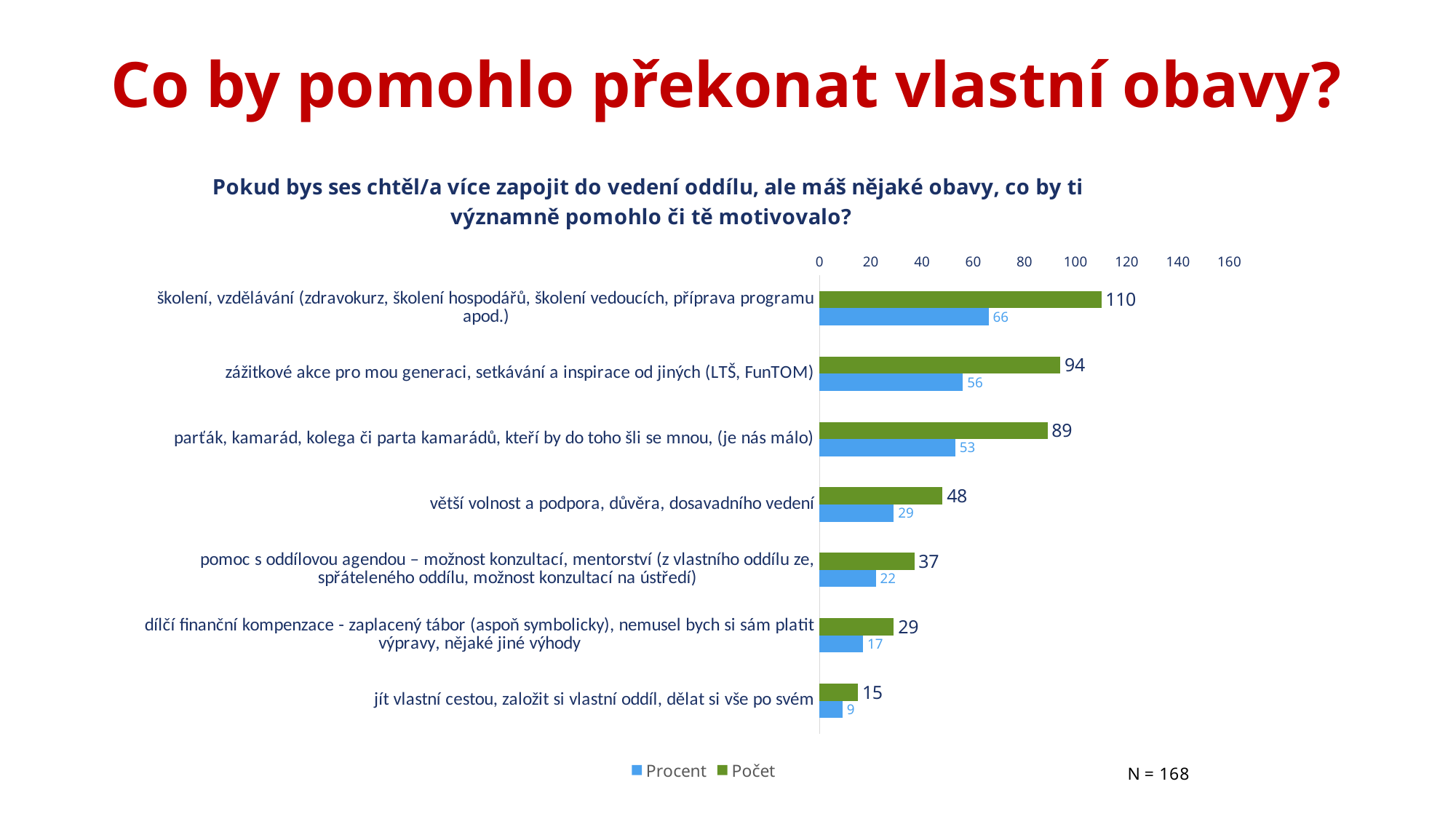
Which has a larger Procent value: "pomoc s oddílovou agendou" or "dílčí finanční kompenzace"? pomoc s oddílovou agendou What is the difference between the Počet values for "zážitkové akce pro mou generaci, setkávání a inspirace od jiných (LTŠ, FunTOM)" and "parťák, kamarád, kolega či parta kamarádů, kteří by do toho šli se mnou, (je nás málo)"? 5 How many categories are shown in the chart? 7 What is the sample size (N) stated on the slide? N = 168 How many series does the legend list? 2 What is the Počet value for "školení, vzdělávání (zdravokurz, školení hospodářů, školení vedoucích, příprava programu apod.)"? 110 What is the Počet value for "větší volnost a podpora, důvěra, dosavadního vedení"? 48 Is the Počet value for "parťák, kamarád, kolega či parta kamarádů, kteří by do toho šli se mnou, (je nás málo)" greater or less than 80? greater Which category has the lowest Počet value? jít vlastní cestou, založit si vlastní oddíl, dělat si vše po svém Which category has the highest Procent value? školení, vzdělávání (zdravokurz, školení hospodářů, školení vedoucích, příprava programu apod.) What is the Procent value for "zážitkové akce pro mou generaci, setkávání a inspirace od jiných (LTŠ, FunTOM)"? 56 What type of chart is shown on the slide? bar chart